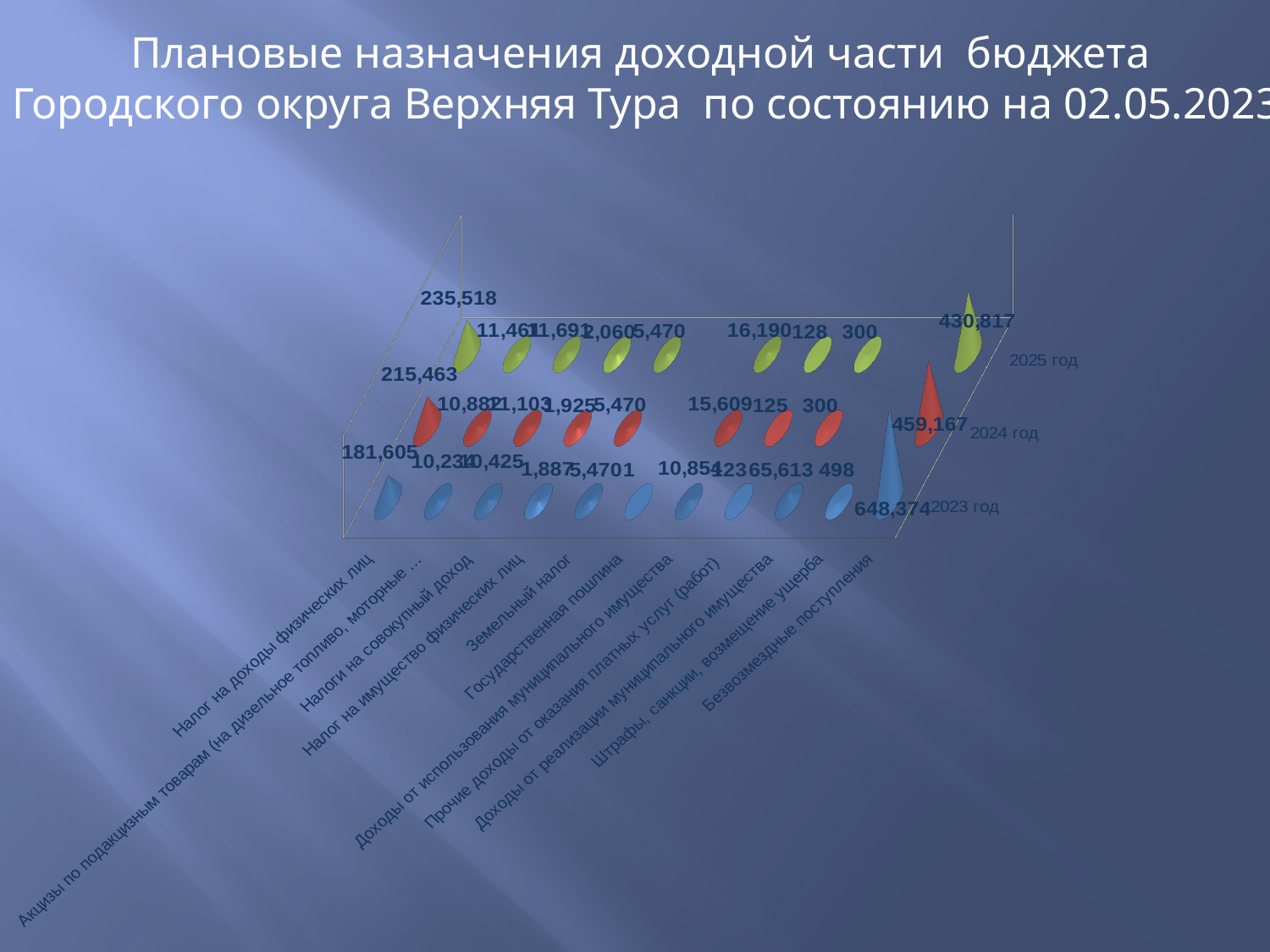
Which is larger for Налог на доходы физических лиц: the 2023 год value or the 2025 год value? 2025 год How many series (years) does the chart show? 3 How many revenue categories are plotted along the x axis? 11 Do the values for Безвозмездные поступления rise or fall from 2023 год to 2025 год? fall Which years are shown as series in the chart? 2023 год, 2024 год, 2025 год What is the value for Доходы от использования муниципального имущества in 2025 год? 16,190 What is the value for Налог на доходы физических лиц in 2024 год? 215,463 What is the value for Безвозмездные поступления in 2025 год? 430,817 What is the value for Безвозмездные поступления in 2023 год? 648,374 What is the difference between the 2025 год and 2023 год values for Налог на доходы физических лиц? 53,913 Which category has the highest value in 2023 год? Безвозмездные поступления What is the difference between the 2023 год and 2025 год values for Безвозмездные поступления? 217,557